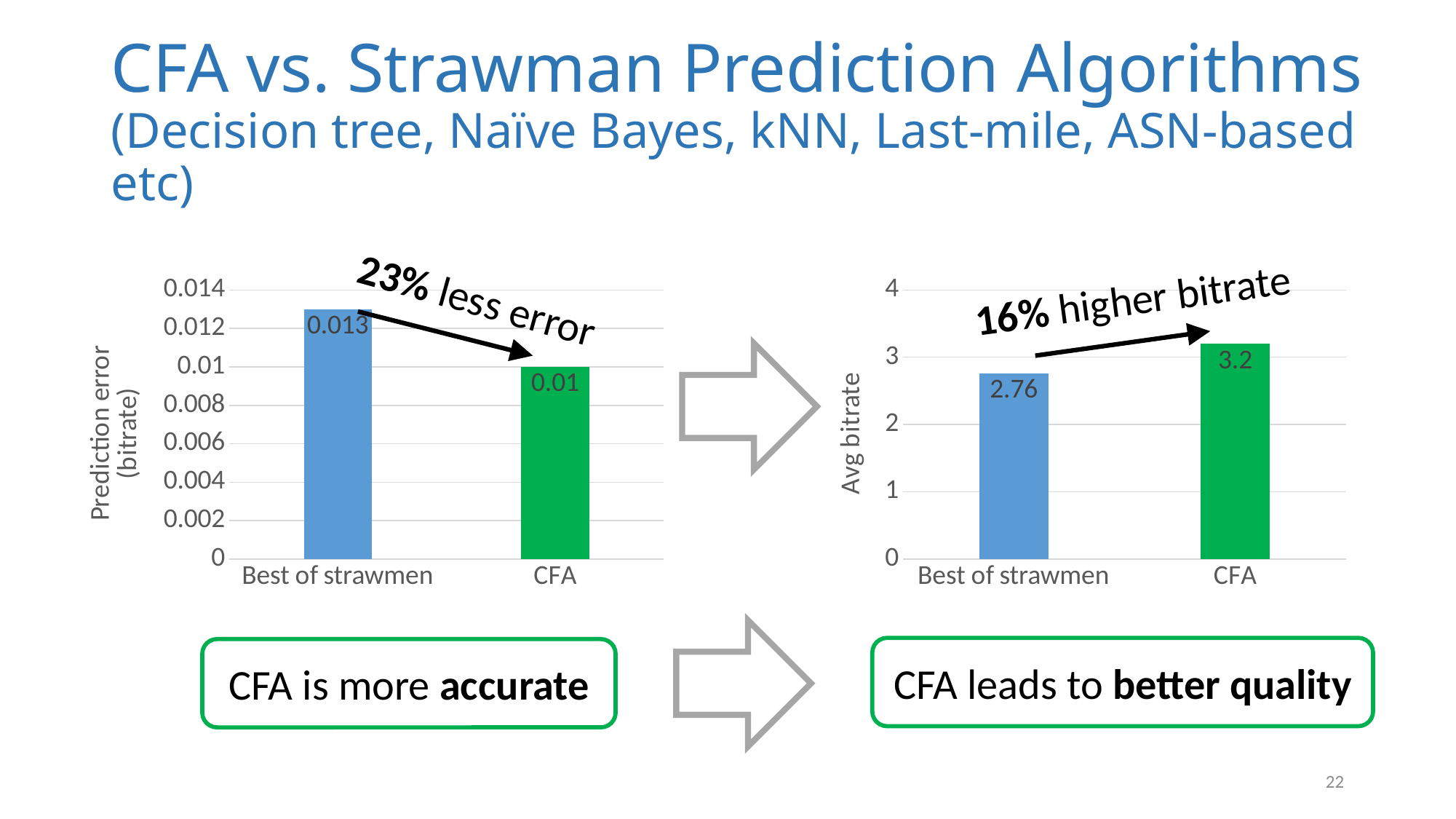
In the left chart (Prediction error), what is the value for Best of strawmen? 0.013 What kind of chart is the right chart (Avg bitrate)? bar chart In the right chart (Avg bitrate), which category has the highest value? CFA In the right chart (Avg bitrate), what is the value for CFA? 3.2 How many categories are shown in the left chart (Prediction error)? 2 In the right chart (Avg bitrate), what is the difference between the CFA value and the Best of strawmen value? 0.44 What is the y-axis label of the right chart? Avg bitrate In the right chart (Avg bitrate), what is the value for Best of strawmen? 2.76 In the left chart (Prediction error), what is the value for CFA? 0.01 In the left chart (Prediction error), what is the difference between the Best of strawmen value and the CFA value? 0.003 In the right chart (Avg bitrate), is the value for Best of strawmen greater or less than 3? less In the left chart (Prediction error), which category has the lowest value? CFA